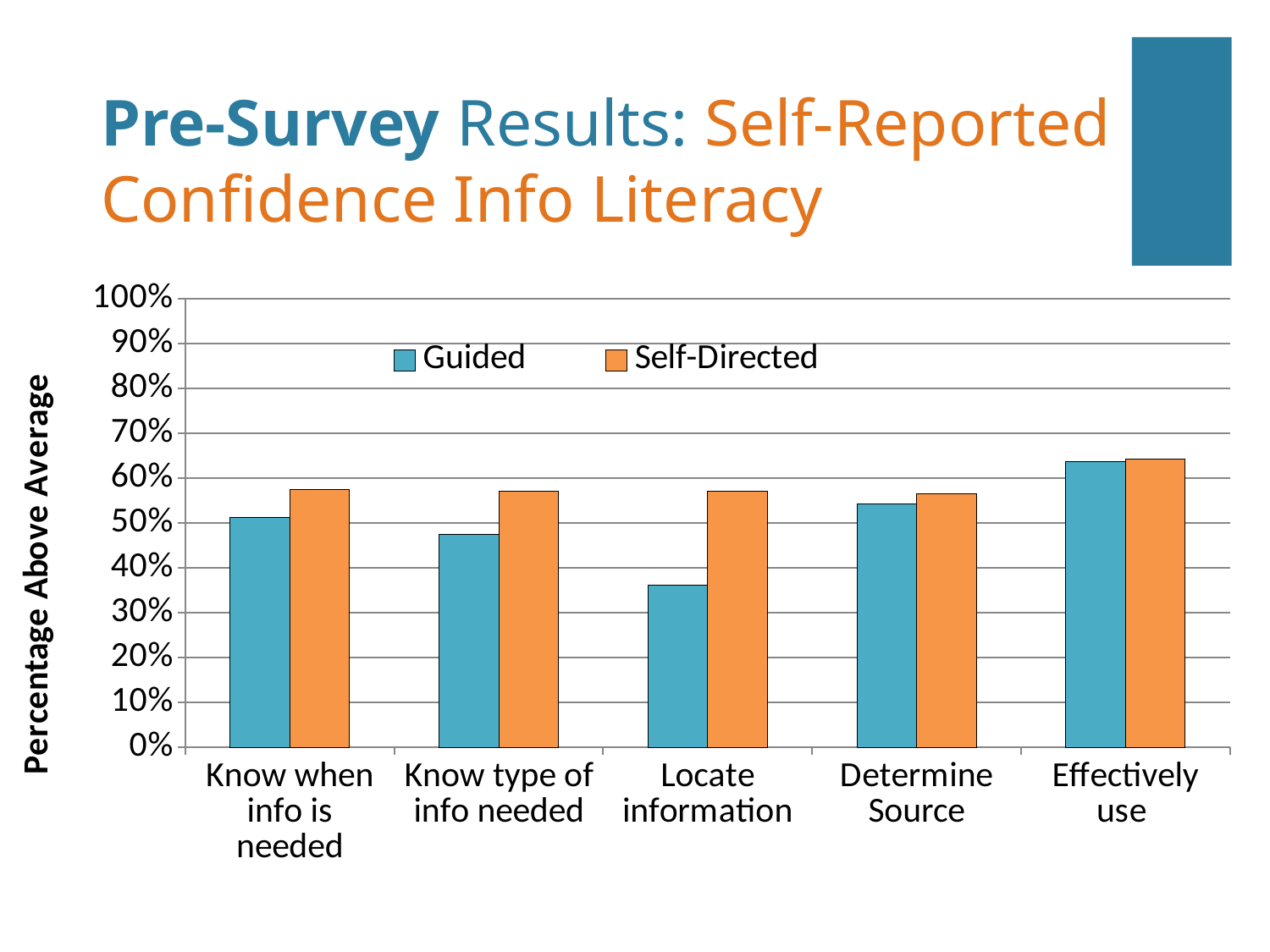
What kind of chart is shown on the slide? bar chart For Know when info is needed, which is larger: Guided or Self-Directed? Self-Directed How many categories are shown on the x axis? 5 Is the Guided value for Locate information greater or less than 40%? less Is the Guided value for Know type of info needed greater or less than 50%? less What is the label of the y axis? Percentage Above Average How many series does the legend list? 2 Which category has the lowest Guided value? Locate information For Locate information, which is larger: Guided or Self-Directed? Self-Directed Which category has the highest Self-Directed value? Effectively use Is the Guided value for Effectively use greater or less than 60%? greater Which category has the highest Guided value? Effectively use